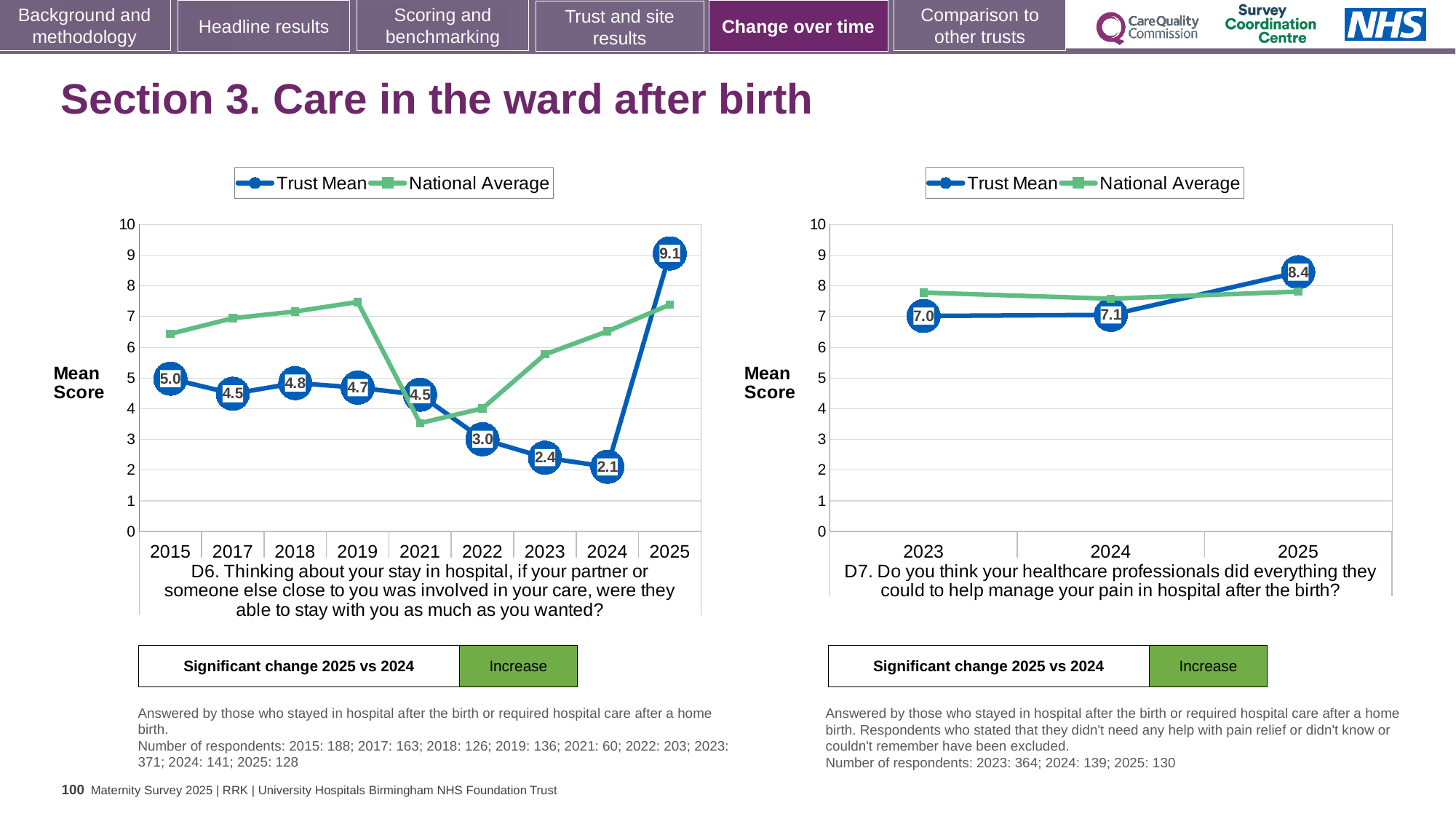
On the left chart (D6), what is the difference between the Trust Mean in 2025 and in 2024? 7.0 On the left chart (D6), which year has the lowest Trust Mean? 2024 On the left chart (D6), is the National Average for 2019 greater or less than 7? greater On the right chart (D7), what is the Trust Mean for 2025? 8.4 What kind of chart is the right chart (D7)? Line chart On the right chart (D7), what is the Trust Mean for 2023? 7.0 On the left chart (D6), which year has the highest Trust Mean? 2025 On the right chart (D7), what is the difference between the Trust Mean in 2025 and in 2024? 1.3 On the left chart (D6), what is the Trust Mean for 2024? 2.1 On the left chart (D6), how many years are shown on the x axis? 9 On the left chart (D6), what is the Trust Mean for 2025? 9.1 On the right chart (D7), how many series does the legend list? 2